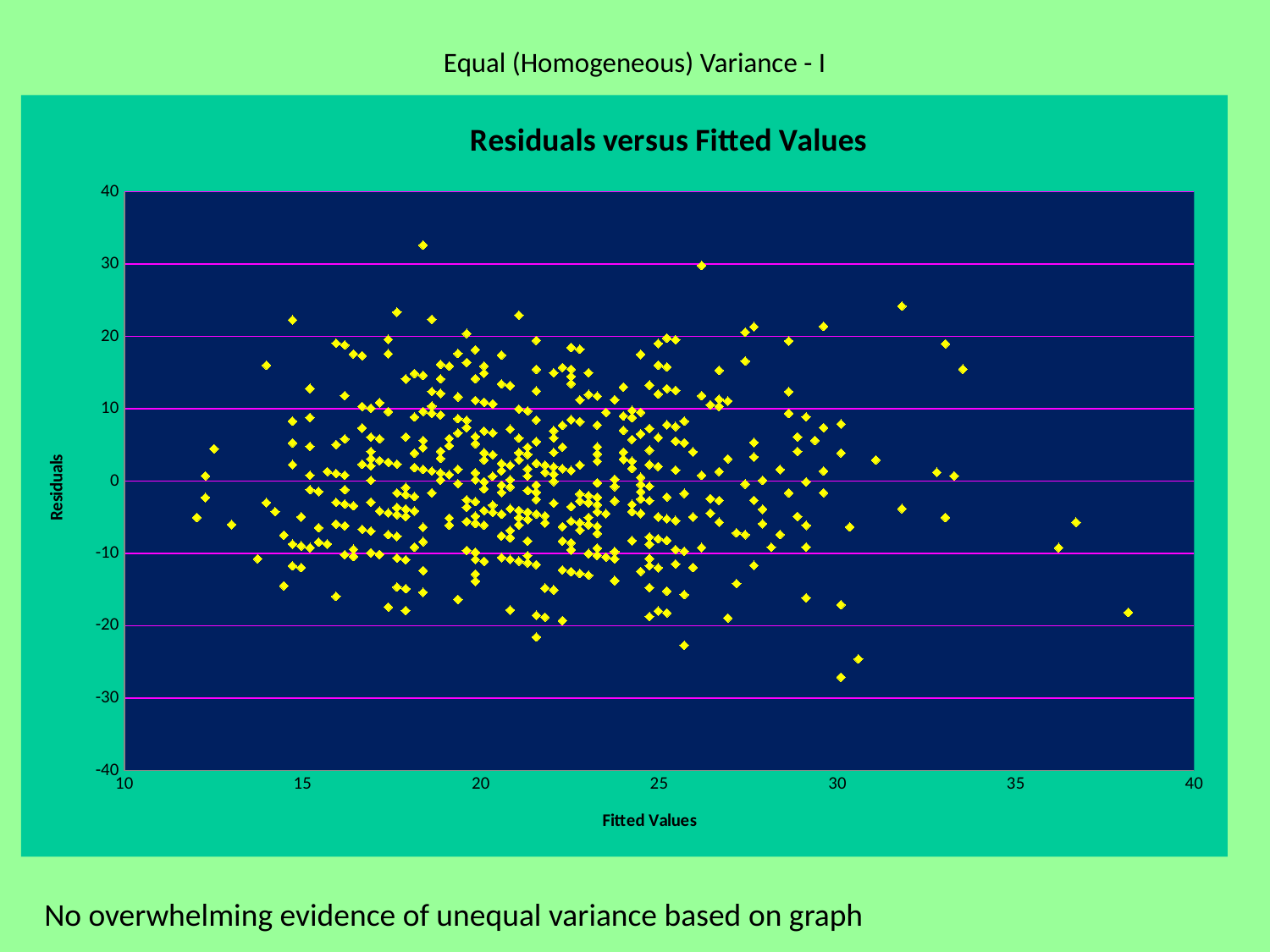
Which is larger: the residual of the highest point (near fitted value 18) or the residual of the point near fitted value 26 that sits close to 30? the point near fitted value 18 Do the residuals show a clear rising or falling trend as fitted values increase? no clear trend Is the highest residual plotted on the chart greater or less than 30? greater What kind of chart is shown on the slide? scatter plot Is the fitted value of the highest plotted point greater or less than 20? less Is the fitted value of the lowest plotted point greater or less than 25? greater What is the title of the chart? Residuals versus Fitted Values What is the label of the horizontal axis? Fitted Values